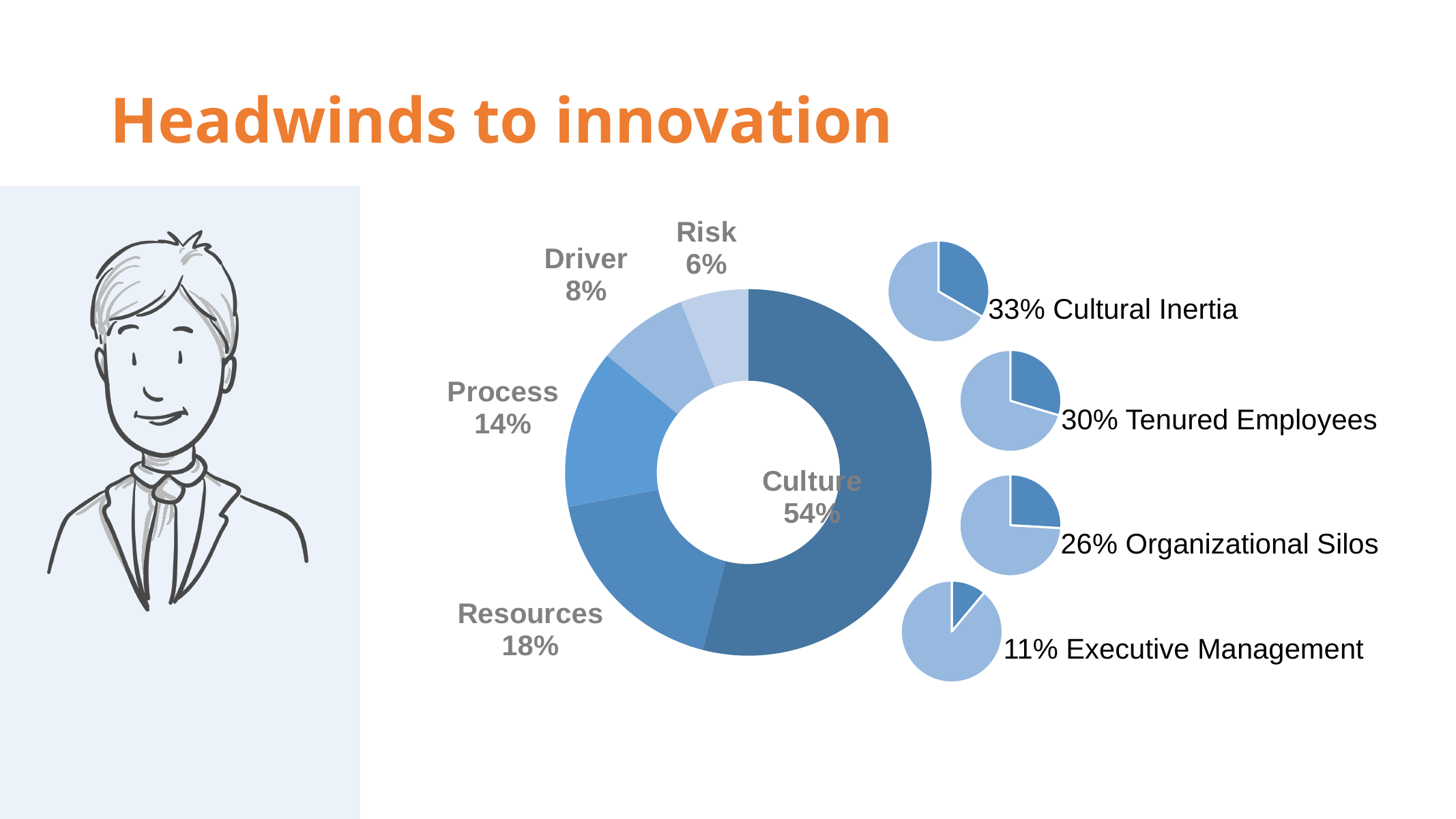
What kind of chart is the large chart in the centre of the slide? Donut chart In the large donut chart, what is the difference between the Culture and Resources shares? 36% In the small pie chart labelled Cultural Inertia, what percentage is shown? 33% In the large donut chart, which is larger, Driver or Risk? Driver In the large donut chart, what percentage is shown for Resources? 18% In the small pie chart labelled Executive Management, what percentage is shown? 11% In the large donut chart, which category has the largest share? Culture In the large donut chart, what percentage is shown for Culture? 54% In the large donut chart, which category has the smallest share? Risk Among the four small pie charts on the right, which label has the highest percentage? Cultural Inertia How many categories does the large donut chart show? 5 In the large donut chart, what percentage is shown for Process? 14%